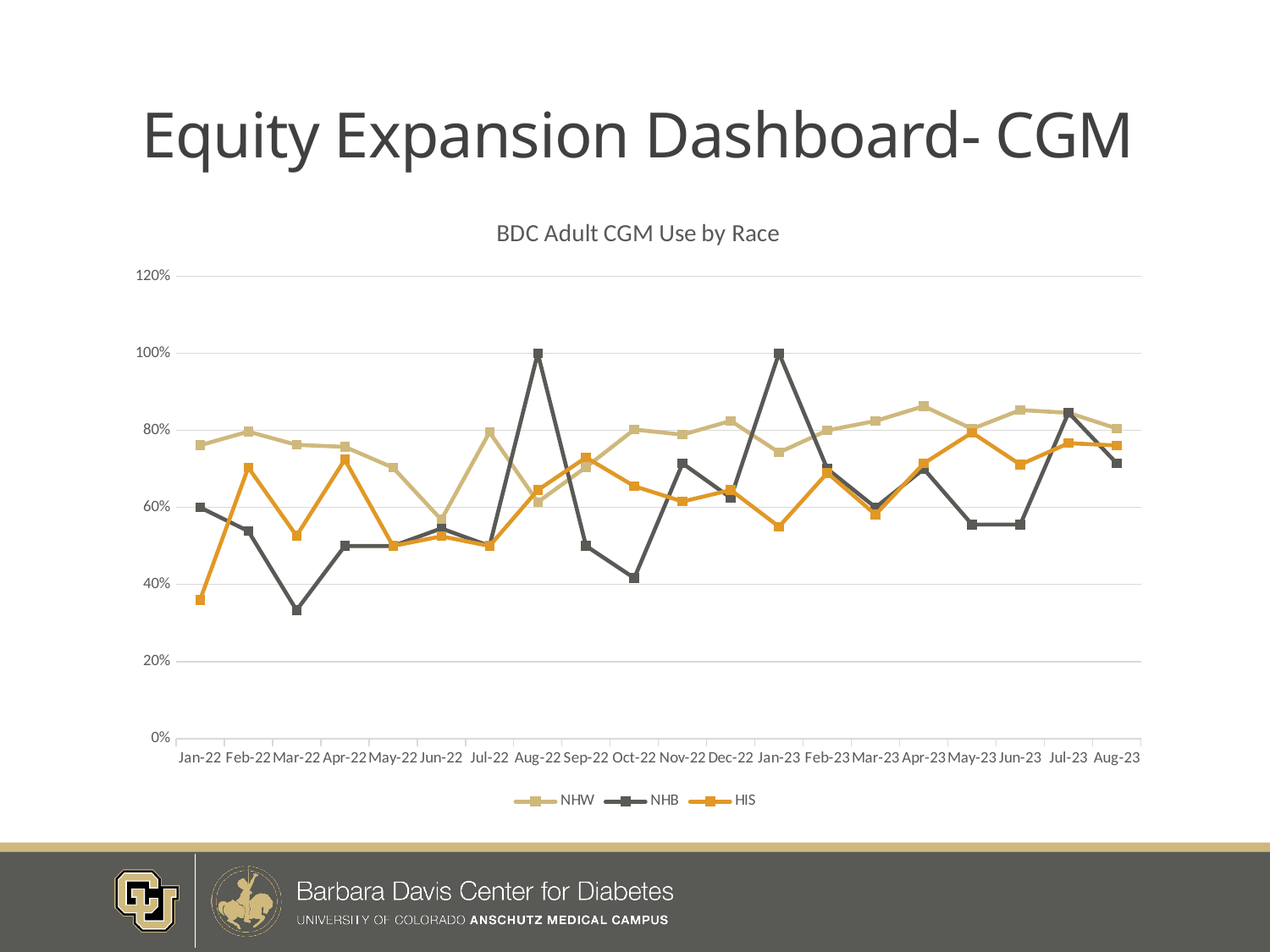
How many months are shown along the x axis? 20 In Jan-22, which series has the higher value, NHW or NHB? NHW How many series does the legend list? 3 Does the HIS series rise or fall overall from Jan-22 to Aug-23? rise What type of chart is shown on the slide? line chart In which month does the NHB series reach its lowest value? Mar-22 Is the value for HIS in Jan-22 greater or less than 40%? less What is the value for NHB in Aug-22? 100% What is the value for NHB in Jan-23? 100% What is the title of the chart? BDC Adult CGM Use by Race Which series reaches the highest value on the chart? NHB Is the value for NHW in Apr-23 greater or less than 80%? greater